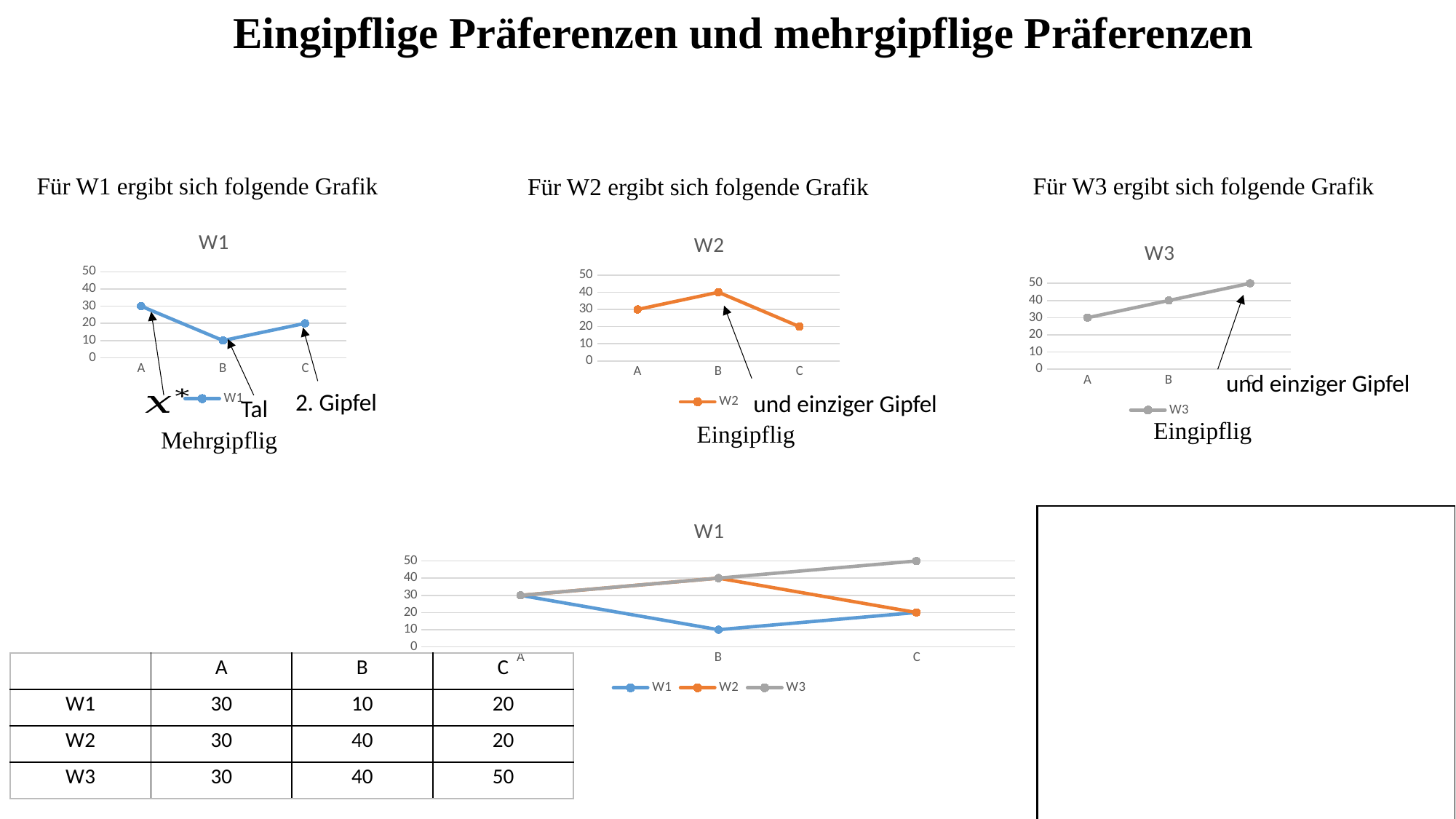
In the top-left chart titled W1, which category has the lowest value? B In the top-left chart titled W1, what is the value for B? 10 In the top-right chart titled W3, do the values rise or fall from A to C? rise In the bottom chart titled W1, how many series does the legend list? 3 In the bottom chart titled W1, how many categories are on the x axis? 3 What kind of chart is the top-middle chart titled W2? line chart In the top-middle chart titled W2, what is the value for B? 40 In the top-middle chart titled W2, what is the difference between the values for B and C? 20 In the bottom chart titled W1, which is larger at C: the value for W2 or the value for W3? W3 In the top-right chart titled W3, what is the value for C? 50 In the top-left chart titled W1, which category has the highest value? A In the top-right chart titled W3, is the value for A greater or less than 40? less